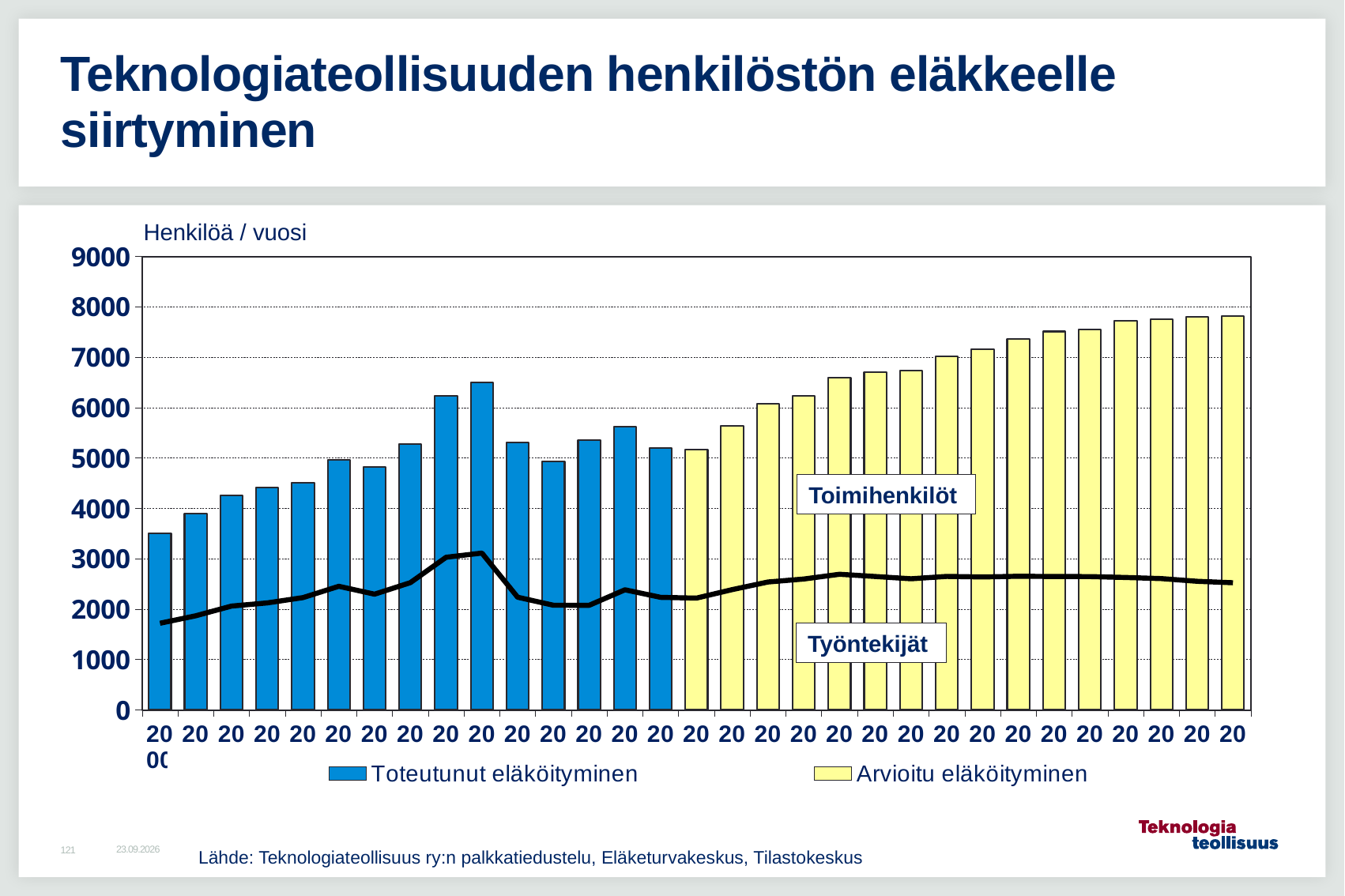
Which legend series is drawn in blue? Toteutunut eläköityminen Which is taller, the rightmost yellow bar or the tallest blue bar? The rightmost yellow bar What are the two legend entries of the chart? Toteutunut eläköityminen and Arvioitu eläköityminen Is the tallest blue bar greater or less than 6000? greater What is the highest value shown on the vertical axis? 9000 How many blue (Toteutunut eläköityminen) bars are in the chart? 15 How many series does the legend list? 2 What is the label shown above the vertical axis of the chart? Henkilöä / vuosi Is the value of the last (rightmost) bar greater or less than 7000? greater What kind of chart is shown on the slide? Combination bar and line chart Do the yellow (Arvioitu eläköityminen) bars rise or fall from left to right? Rise Is the value of the first (leftmost) bar greater or less than 4000? less